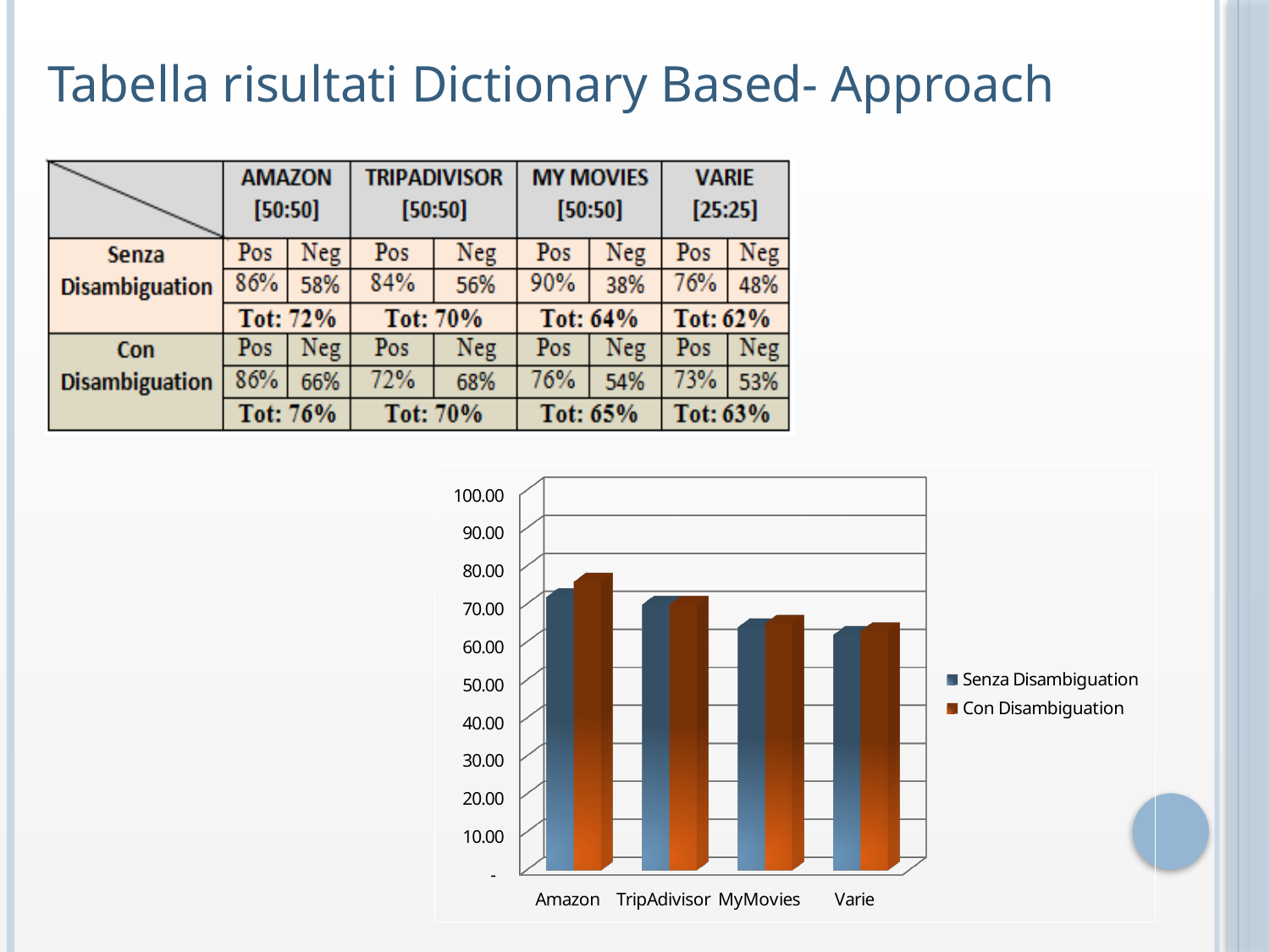
Is the Senza Disambiguation value for TripAdvisor greater or less than 60? greater Is the Con Disambiguation value for Amazon greater or less than 70? greater How many series does the chart legend list? 2 For Amazon, which series has the larger bar, Senza Disambiguation or Con Disambiguation? Con Disambiguation How many categories are shown on the x axis of the chart? 4 What kind of chart is shown on the slide? bar chart Which series is shown in orange in the chart? Con Disambiguation Which category has the highest Senza Disambiguation bar in the chart? Amazon Do the Senza Disambiguation values rise or fall from Amazon to Varie along the x axis? fall Which category has the lowest Con Disambiguation bar in the chart? Varie Is the Con Disambiguation value for Amazon greater or less than 80? less